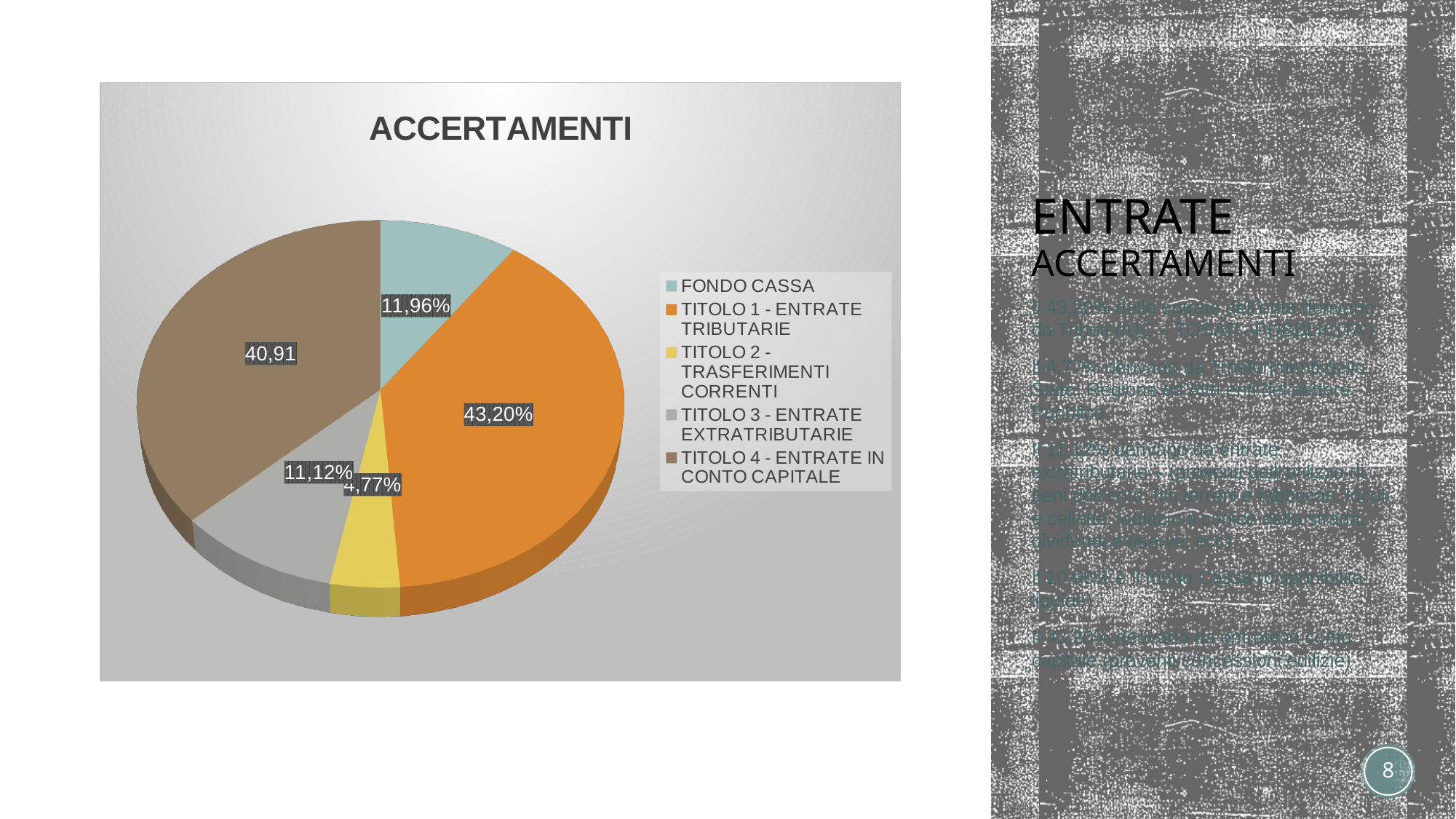
What is the value shown for TITOLO 1 - ENTRATE TRIBUTARIE? 43,20% What is the value shown for TITOLO 4 - ENTRATE IN CONTO CAPITALE? 40,91 What type of chart is shown on the slide? pie chart What is the value shown for FONDO CASSA? 11,96% What is the title of the chart? ACCERTAMENTI Which category has the largest slice of the pie? TITOLO 1 - ENTRATE TRIBUTARIE Which category has the smallest slice of the pie? TITOLO 2 - TRASFERIMENTI CORRENTI Which is larger, the slice for TITOLO 1 - ENTRATE TRIBUTARIE or the slice for TITOLO 4 - ENTRATE IN CONTO CAPITALE? TITOLO 1 - ENTRATE TRIBUTARIE What is the value shown for TITOLO 2 - TRASFERIMENTI CORRENTI? 4,77% How many categories does the pie chart have? 5 What colour is the slice for TITOLO 2 - TRASFERIMENTI CORRENTI? yellow What is the value shown for TITOLO 3 - ENTRATE EXTRATRIBUTARIE? 11,12%